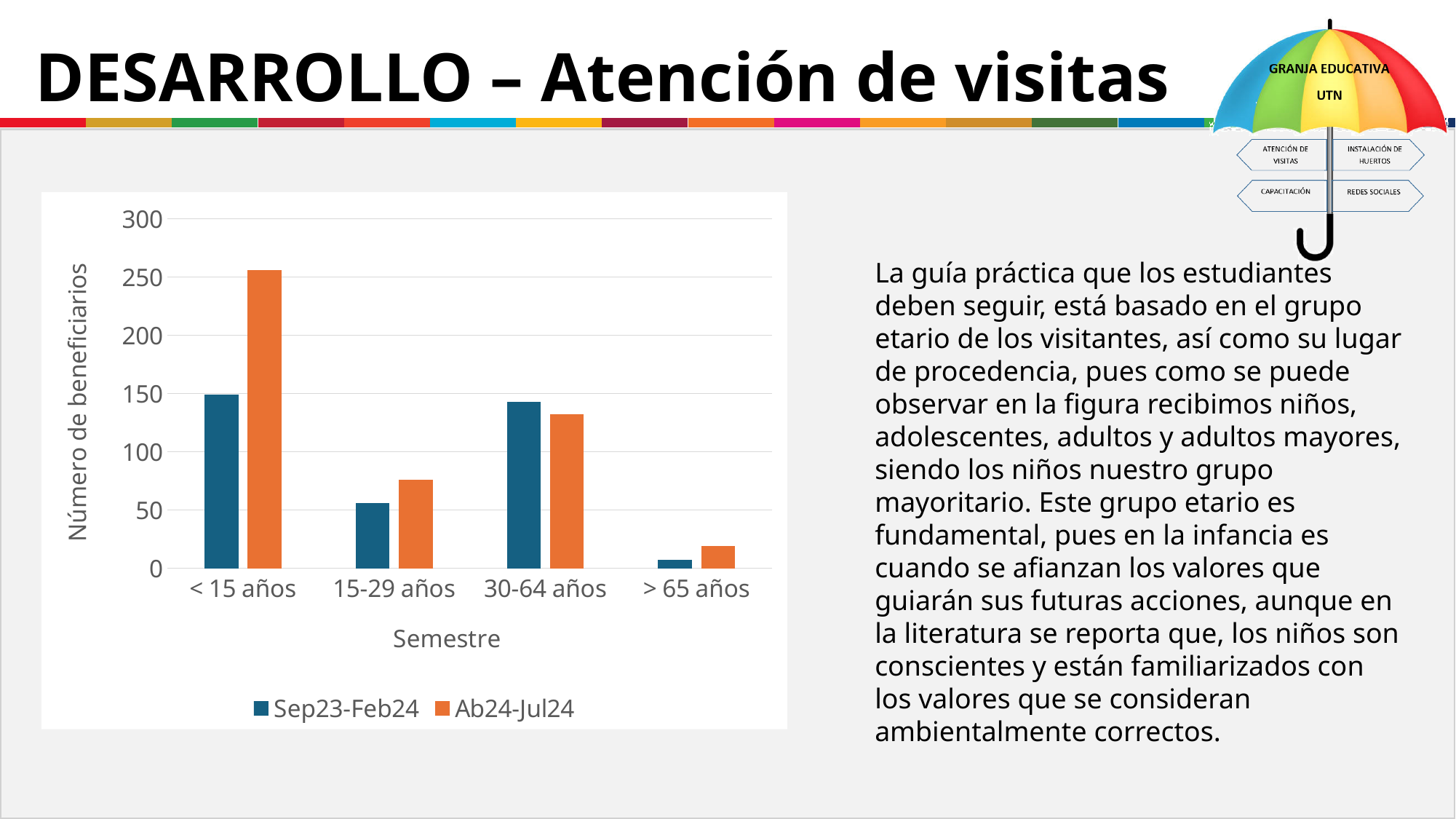
Which age category has the lowest value for the Sep23-Feb24 series? > 65 años How many age categories are shown on the x axis of the chart? 4 What is the label of the y axis of the chart? Número de beneficiarios What kind of chart is shown on the slide? bar chart How many series does the chart legend list? 2 Which age category has the lowest value for the Ab24-Jul24 series? > 65 años Is the Ab24-Jul24 value for < 15 años greater or less than 200? greater For the < 15 años category, which series has the larger value, Sep23-Feb24 or Ab24-Jul24? Ab24-Jul24 For the 30-64 años category, which series has the larger value, Sep23-Feb24 or Ab24-Jul24? Sep23-Feb24 Is the Sep23-Feb24 value for 15-29 años greater or less than 100? less Is the Ab24-Jul24 value for > 65 años greater or less than 50? less Which age category has the highest value for the Ab24-Jul24 series? < 15 años